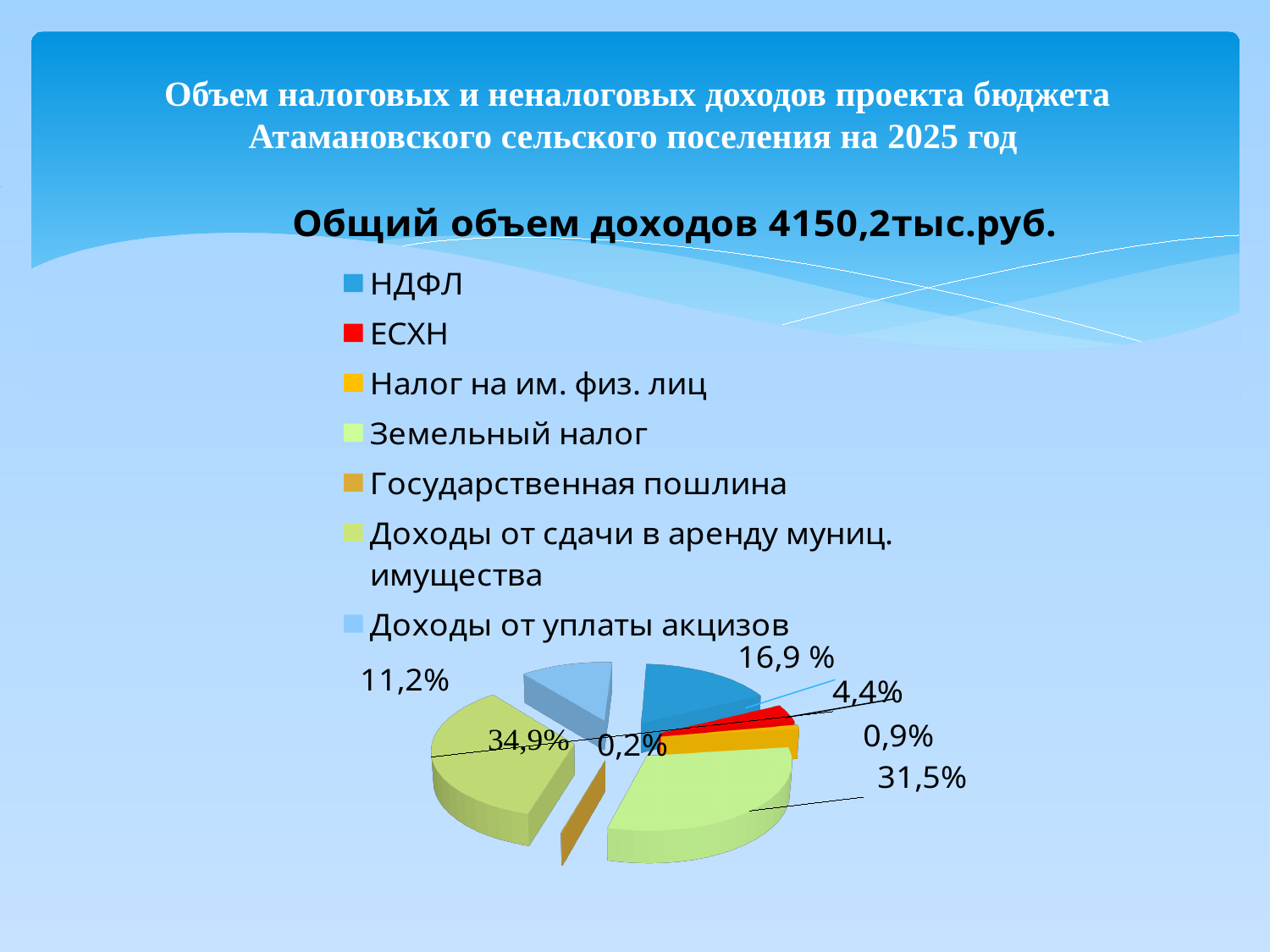
What share of the pie does Доходы от сдачи в аренду муниц. имущества have? 34,9% What share of the pie does Государственная пошлина have? 0,2% What share of the pie does Земельный налог have? 31,5% How many categories does the legend of the pie chart list? 7 Which category has the largest share of the pie? Доходы от сдачи в аренду муниц. имущества Which has the larger share: НДФЛ or Доходы от уплаты акцизов? НДФЛ Which category has the smallest share of the pie? Государственная пошлина What is the title of the chart? Общий объем доходов 4150,2тыс.руб. What kind of chart is shown on the slide? Pie chart What is the difference in percentage points between the shares of Доходы от сдачи в аренду муниц. имущества and Земельный налог? 3,4